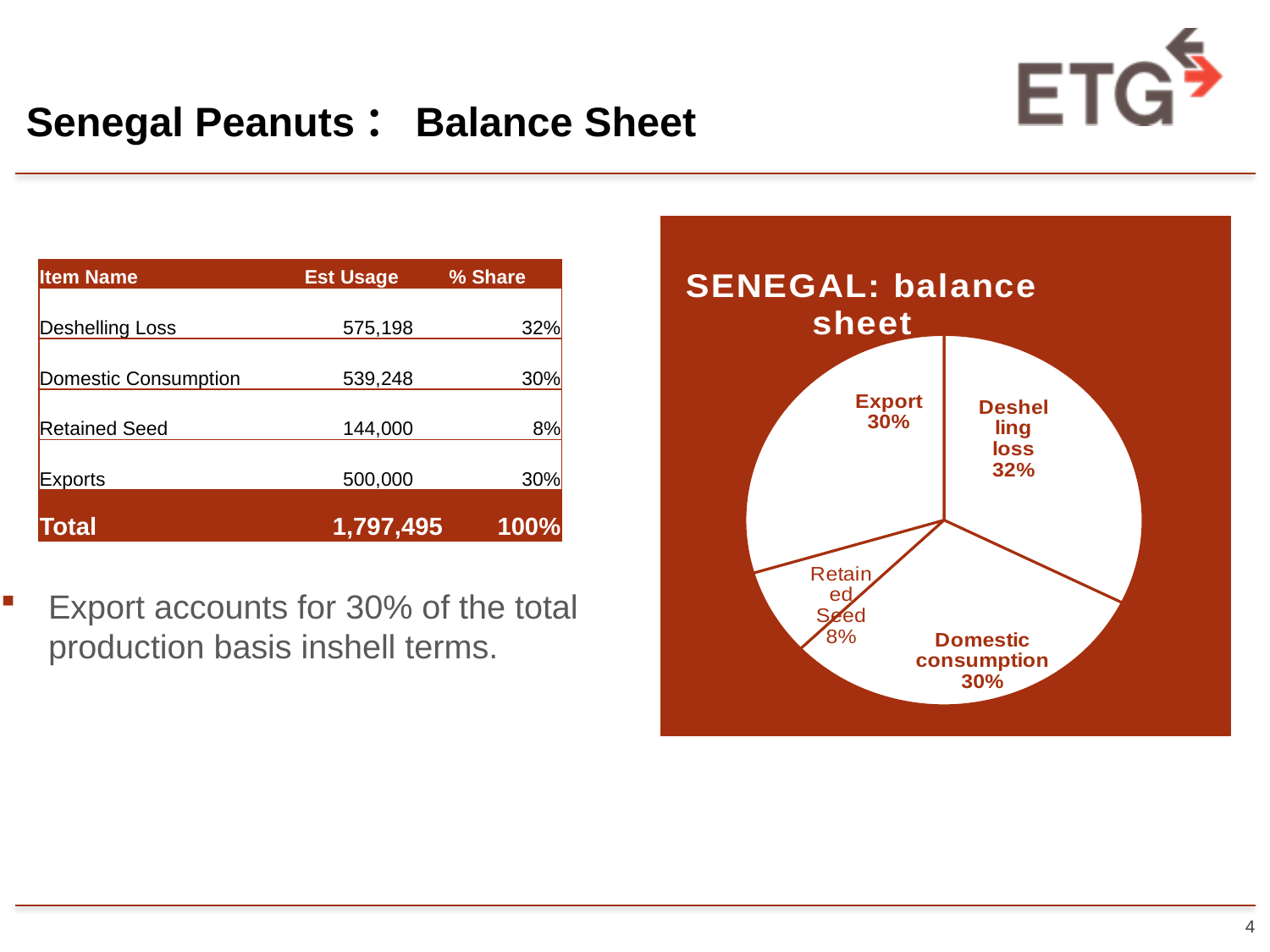
Which is larger, the Deshelling loss slice or the Export slice? Deshelling loss How many slices does the pie chart have? 4 Which slice of the pie chart is the smallest? Retained Seed What share of the pie does Deshelling loss account for? 32% What is the title of the chart? SENEGAL: balance sheet Which slice of the pie chart is the largest? Deshelling loss What share of the pie does Export account for? 30% What kind of chart is shown on the slide? pie chart What is the difference in percentage points between the Deshelling loss slice and the Retained Seed slice? 24 What is the combined share of the Export and Domestic consumption slices? 60% What share of the pie does Domestic consumption account for? 30%